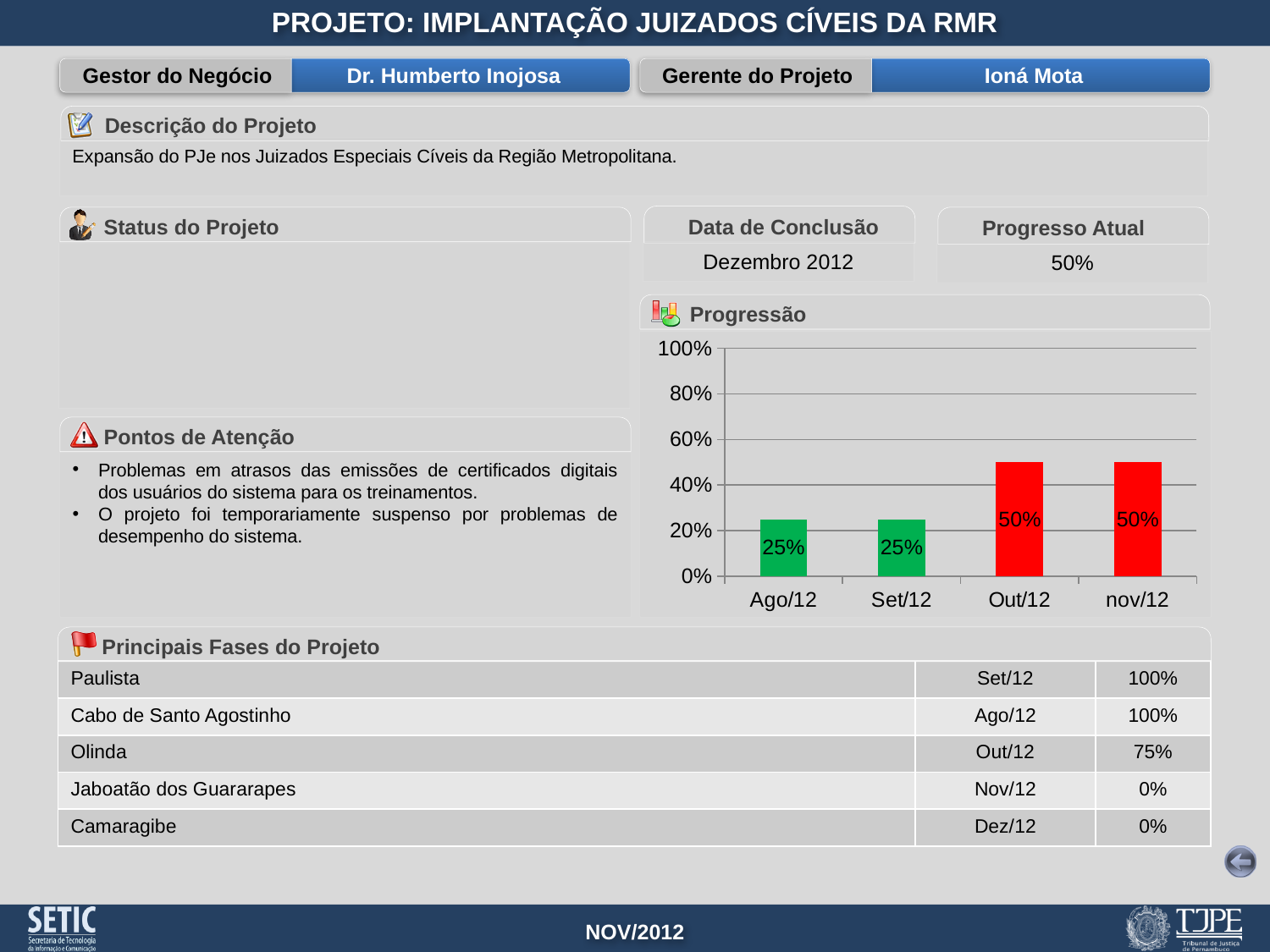
What colour are the bars for Out/12 and nov/12 in the Progressão chart? red What is the value for Ago/12 in the Progressão chart? 25% Which is larger in the Progressão chart, the value for Ago/12 or the value for nov/12? nov/12 What kind of chart is the Progressão chart? bar chart How many categories are shown on the x axis of the Progressão chart? 4 What is the difference between the values for Out/12 and Set/12 in the Progressão chart? 25% What is the value for Out/12 in the Progressão chart? 50% What is the value for nov/12 in the Progressão chart? 50% Is the value for Out/12 in the Progressão chart greater or less than 40%? greater Do the values in the Progressão chart rise or fall from Ago/12 to nov/12? rise Is the value for Ago/12 in the Progressão chart greater or less than 40%? less What is the value for Set/12 in the Progressão chart? 25%